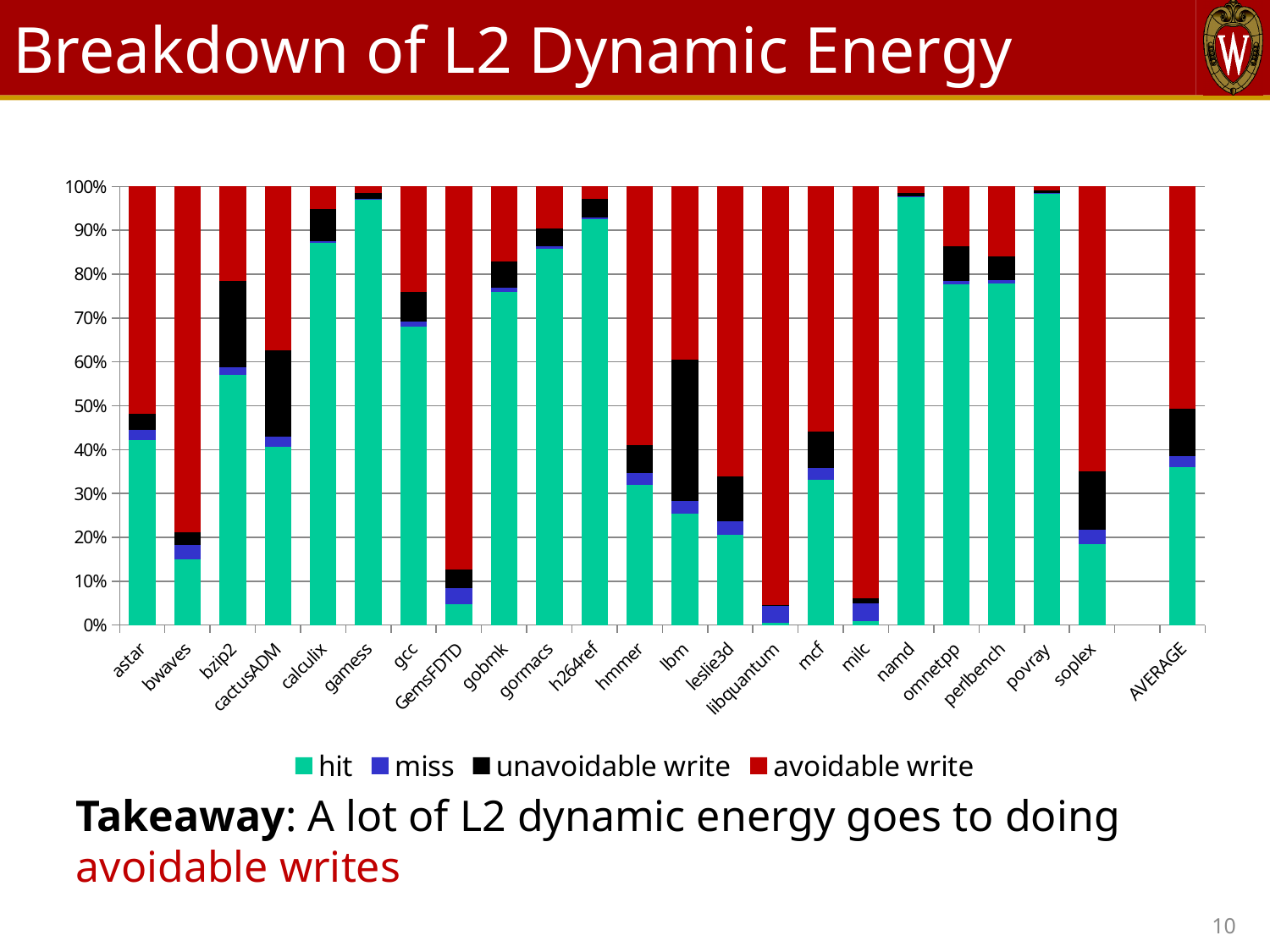
Which has a larger hit share, bzip2 or hmmer? bzip2 Which colour represents avoidable write in the legend? red What does each stacked bar total on the y axis? 100% Is the hit share for AVERAGE greater or less than 40%? less Is the hit share for gamess greater or less than 90%? greater Is the hit share for bwaves greater or less than 20%? less How many categories are shown along the x axis, including AVERAGE? 23 How many series does the legend list? 4 Which has a larger hit share, calculix or gcc? calculix What kind of chart is shown on the slide? stacked bar chart